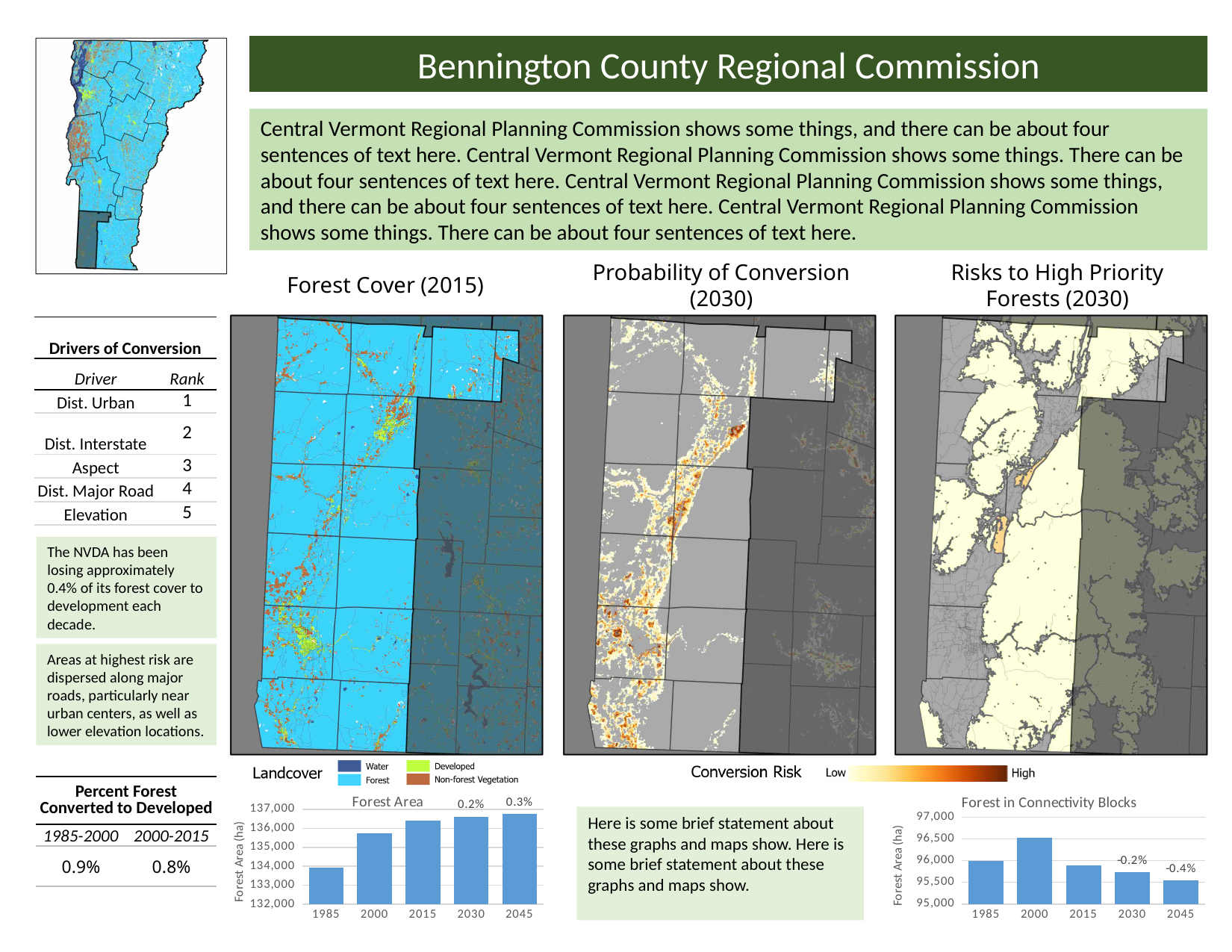
In the "Forest in Connectivity Blocks" chart, which year has the lowest value? 2045 In the "Forest Area" chart, what percentage label is printed above the 2045 bar? 0.3% In the "Forest Area" chart, is the value for 2015 greater or less than 136,000? greater In the "Forest Area" chart, which year has the lowest forest area? 1985 In the "Forest in Connectivity Blocks" chart, what percentage label is printed above the 2030 bar? -0.2% What is the y-axis label of the "Forest in Connectivity Blocks" chart? Forest Area (ha) In the "Forest in Connectivity Blocks" chart, which year has the highest value? 2000 In the "Forest in Connectivity Blocks" chart, is the value for 2000 greater or less than 96,000? greater How many years are shown on the x axis of the "Forest Area" chart? 5 In the "Forest Area" chart, do the values rise or fall from 1985 to 2045? rise What kind of chart is the "Forest Area" chart at the bottom of the slide? bar chart In the "Forest Area" chart, is the value for 2000 greater or less than 135,000? greater